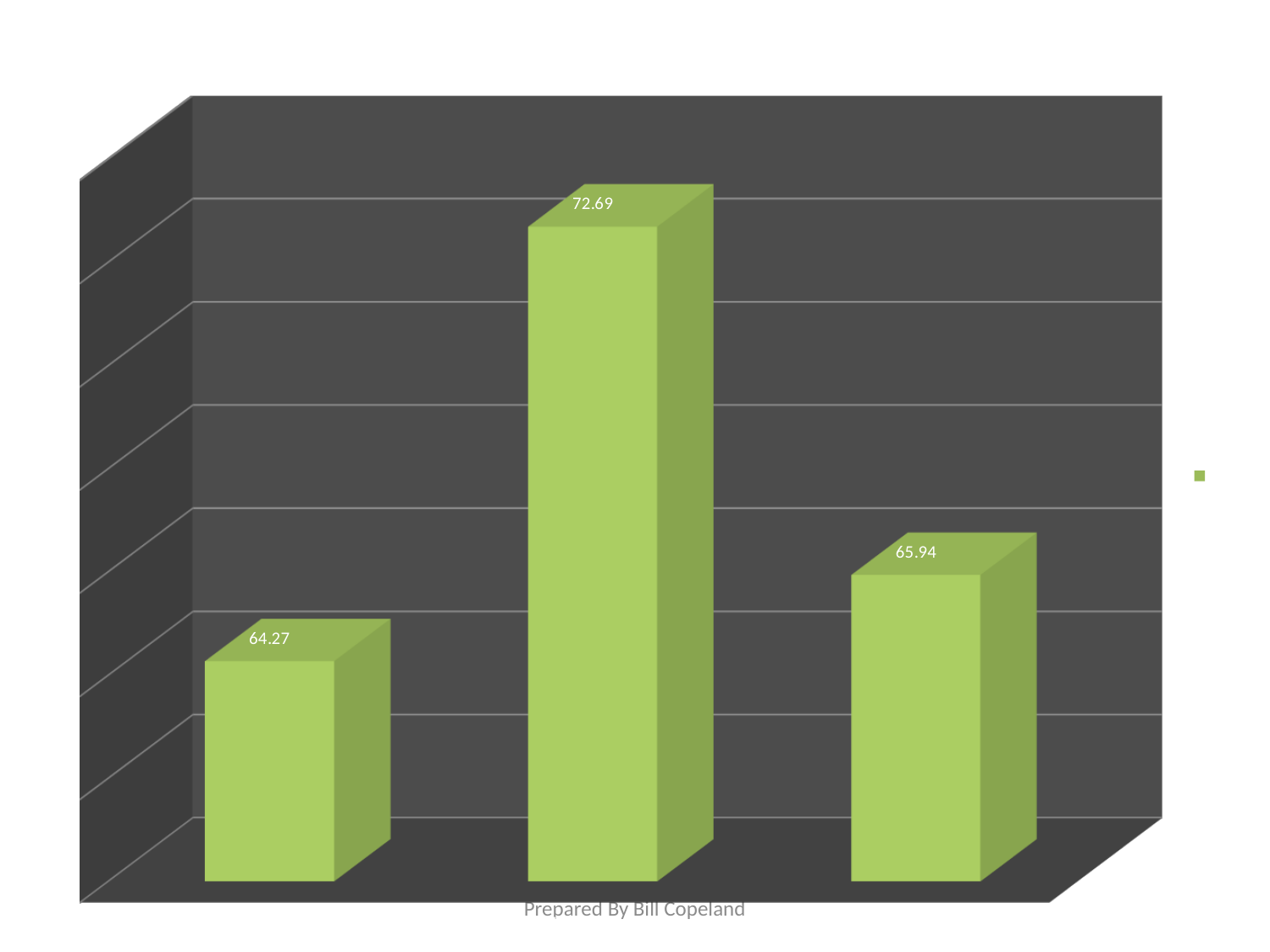
What is the value shown on the right bar? 65.94 What is the difference between the right bar's value and the left bar's value? 1.67 Which is larger, the value of the right bar or the value of the left bar? the right bar What kind of chart is shown on the slide? bar chart What colour are the bars in the chart? green Which bar has the lowest value: left, middle or right? left How many bars are plotted in the chart? 3 What is the difference between the middle bar's value and the left bar's value? 8.42 What is the value shown on the left bar? 64.27 Does the value rise or fall from the middle bar to the right bar? fall Which bar has the highest value: left, middle or right? middle What is the value shown on the middle bar? 72.69